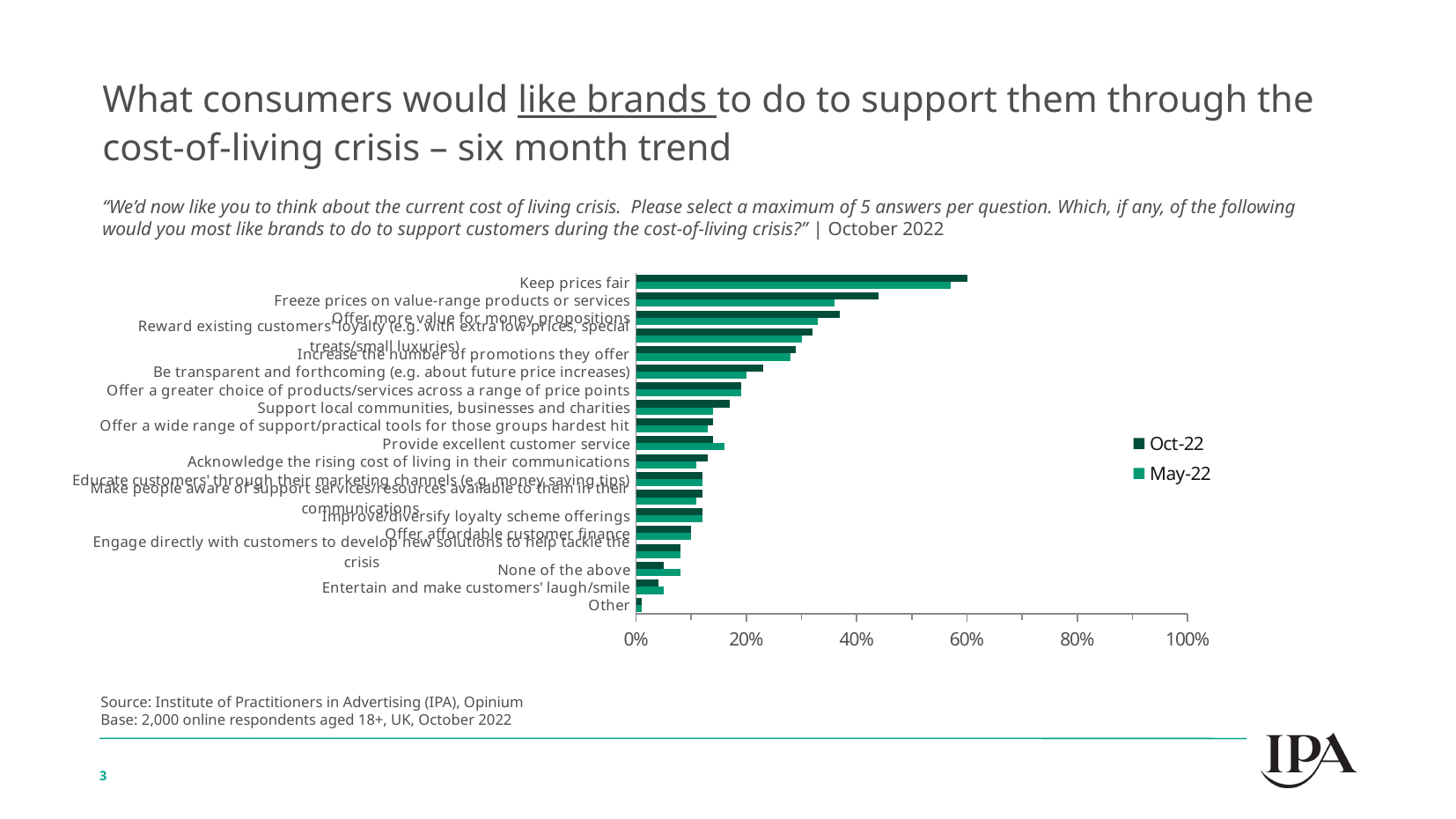
Is the Oct-22 value for Offer more value for money propositions greater or less than 40%? less Is the May-22 value for Keep prices fair greater or less than 40%? greater What kind of chart is shown on the slide? bar chart For Oct-22, which is larger: Keep prices fair or Freeze prices on value-range products or services? Keep prices fair Which category has the highest value for Oct-22? Keep prices fair For Oct-22, which is larger: Provide excellent customer service or Keep prices fair? Keep prices fair Is the Oct-22 value for Keep prices fair greater or less than 40%? greater Which two series are listed in the legend? Oct-22 and May-22 How many series does the legend list? 2 Which category has the lowest value for Oct-22? Other